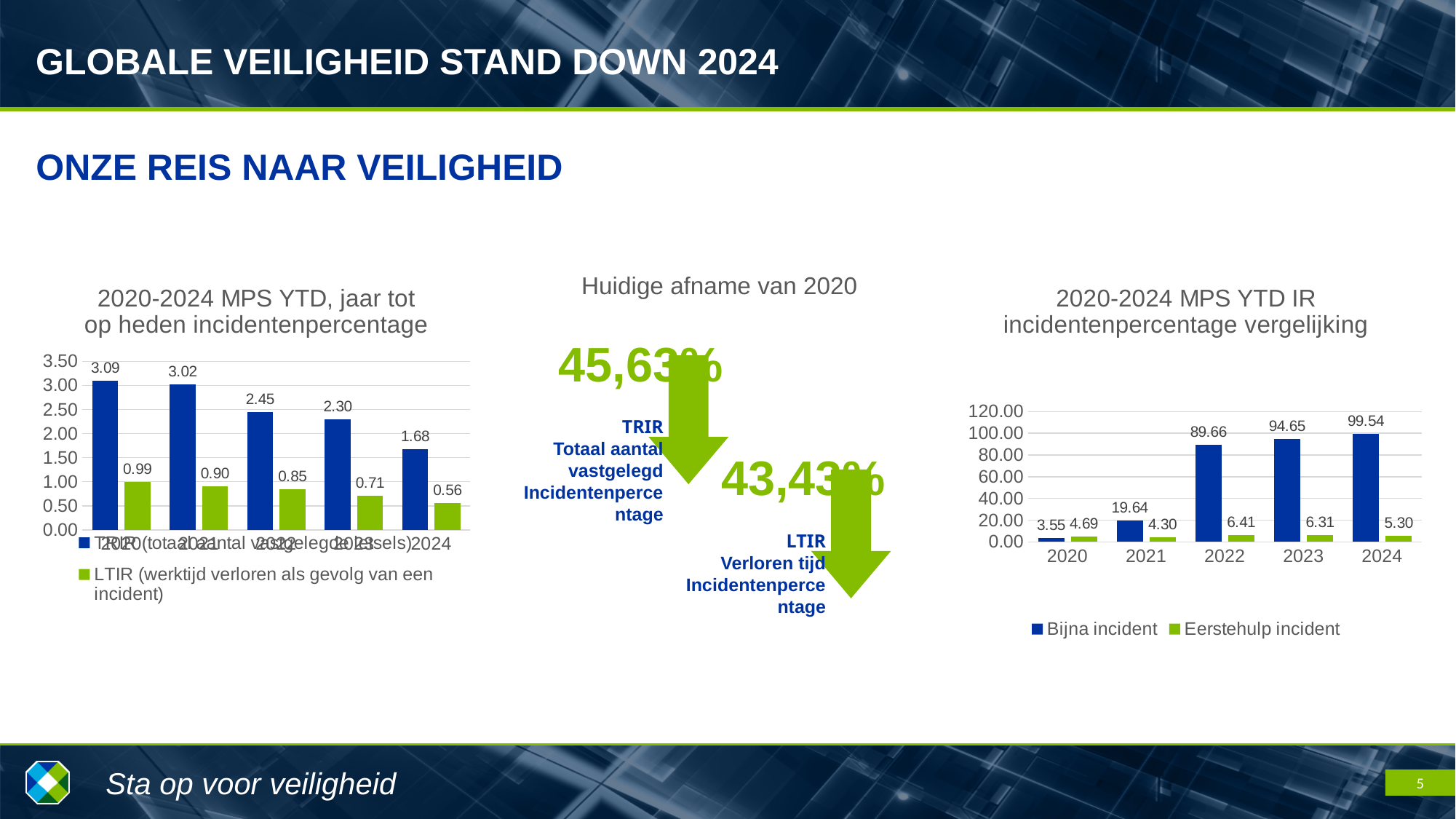
In the chart titled '2020-2024 MPS YTD, jaar tot op heden incidentenpercentage', what is the TRIR value for the first year shown (2020)? 3.09 In the chart titled '2020-2024 MPS YTD IR incidentenpercentage vergelijking', how many series does the legend list? 2 In the chart titled '2020-2024 MPS YTD IR incidentenpercentage vergelijking', what is the value for Eerstehulp incident in 2024? 5.30 In the chart titled '2020-2024 MPS YTD IR incidentenpercentage vergelijking', which year has the lowest Bijna incident value? 2020 In the chart titled '2020-2024 MPS YTD, jaar tot op heden incidentenpercentage', what is the difference between the TRIR values for 2020 and 2024? 1.41 What kind of chart is the chart titled '2020-2024 MPS YTD, jaar tot op heden incidentenpercentage'? bar chart In the chart titled '2020-2024 MPS YTD IR incidentenpercentage vergelijking', what is the value for Bijna incident in 2022? 89.66 In the chart titled '2020-2024 MPS YTD IR incidentenpercentage vergelijking', what is the difference between the Bijna incident values for 2024 and 2023? 4.89 In the chart titled '2020-2024 MPS YTD IR incidentenpercentage vergelijking', does the Bijna incident value rise or fall from 2020 to 2024? rise In the chart titled '2020-2024 MPS YTD, jaar tot op heden incidentenpercentage', what is the LTIR value for the last year shown (2024)? 0.56 In the chart titled '2020-2024 MPS YTD, jaar tot op heden incidentenpercentage', does the TRIR value rise or fall across the years from 2020 to 2024? fall In the chart titled '2020-2024 MPS YTD IR incidentenpercentage vergelijking', which year has the highest Bijna incident value? 2024